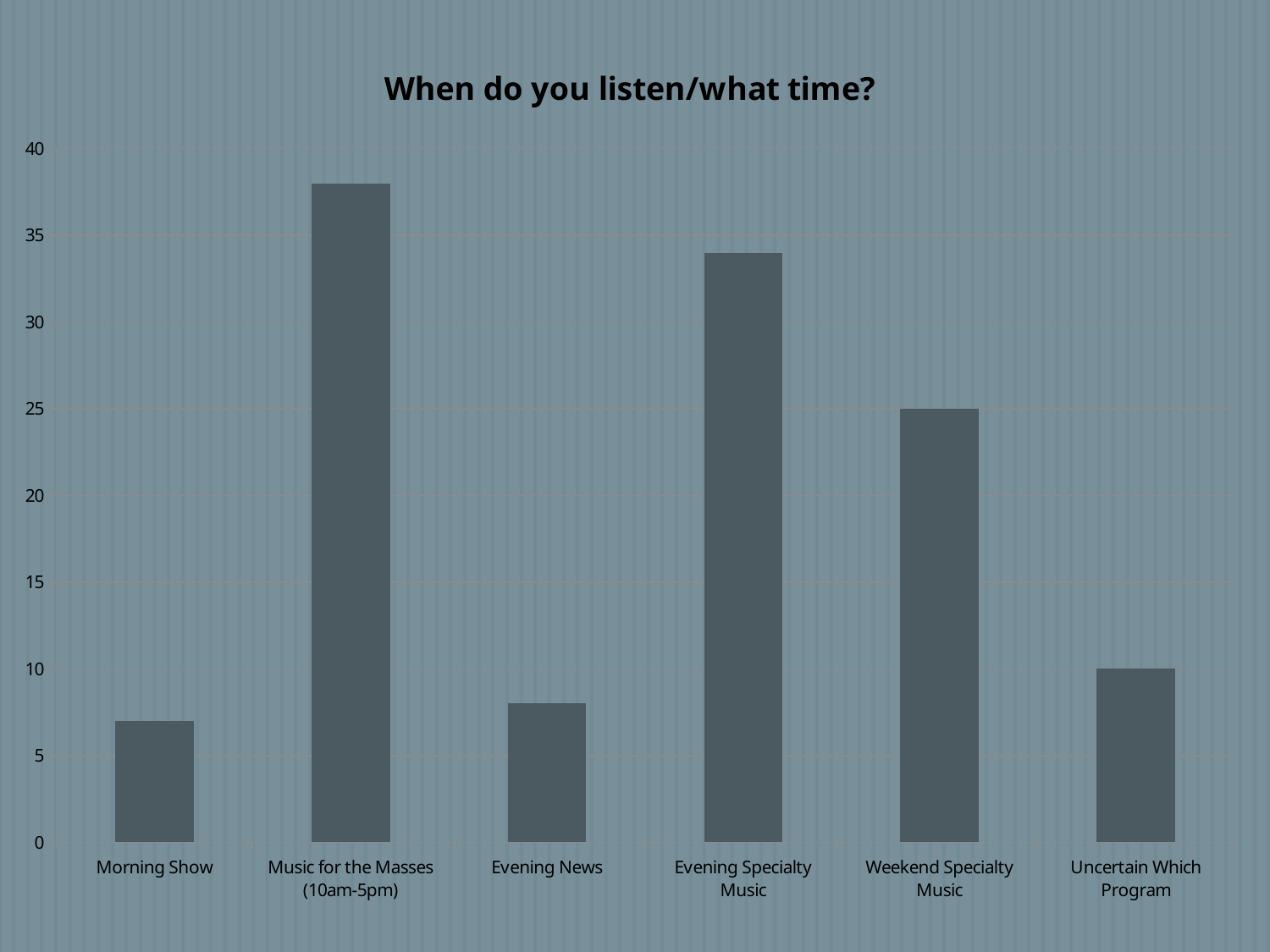
What is the title of the chart? When do you listen/what time? Is the value for Evening News greater or less than 10? less Which is larger, the value for Evening Specialty Music or the value for Weekend Specialty Music? Evening Specialty Music Is the value for Evening Specialty Music greater or less than 30? greater Is the value for Music for the Masses (10am-5pm) greater or less than 35? greater What is the value for Uncertain Which Program? 10 Which category has the highest value? Music for the Masses (10am-5pm) Which category has the lowest value? Morning Show What is the difference between the values for Weekend Specialty Music and Uncertain Which Program? 15 How many categories are shown on the x axis? 6 What kind of chart is shown on the slide? bar chart What is the value for Weekend Specialty Music? 25